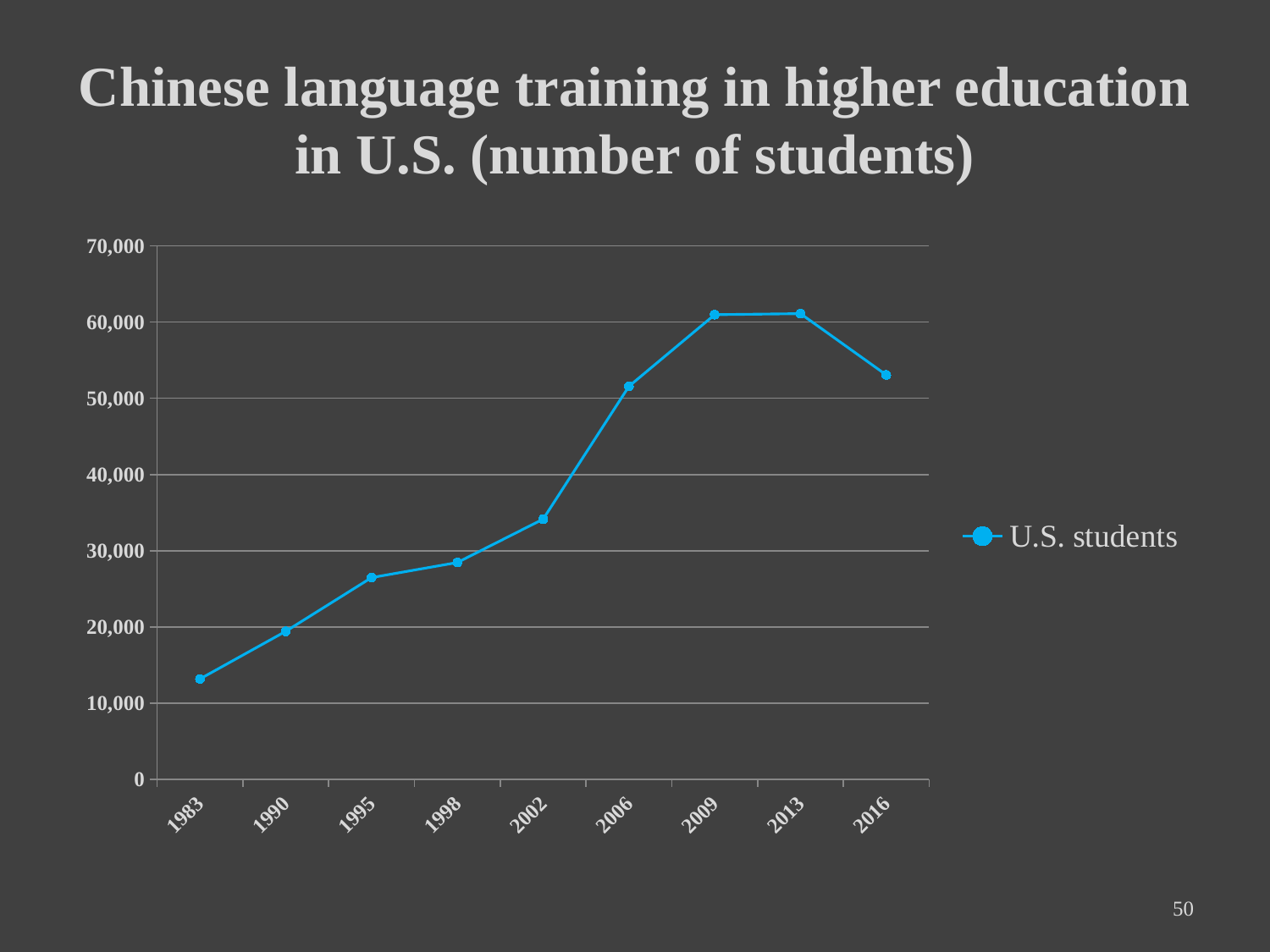
Is the value for 2006 greater or less than 40,000? greater How many years are plotted on the x axis? 9 Is the value for 1983 greater or less than 20,000? less Which year has more U.S. students, 2002 or 2006? 2006 How many series does the legend list? 1 What kind of chart is shown on the slide? line chart Which year has the lowest number of U.S. students? 1983 Is the value for 1995 greater or less than 30,000? less What is the name of the series shown in the legend? U.S. students Do the values rise or fall from 1983 to 2009? rise